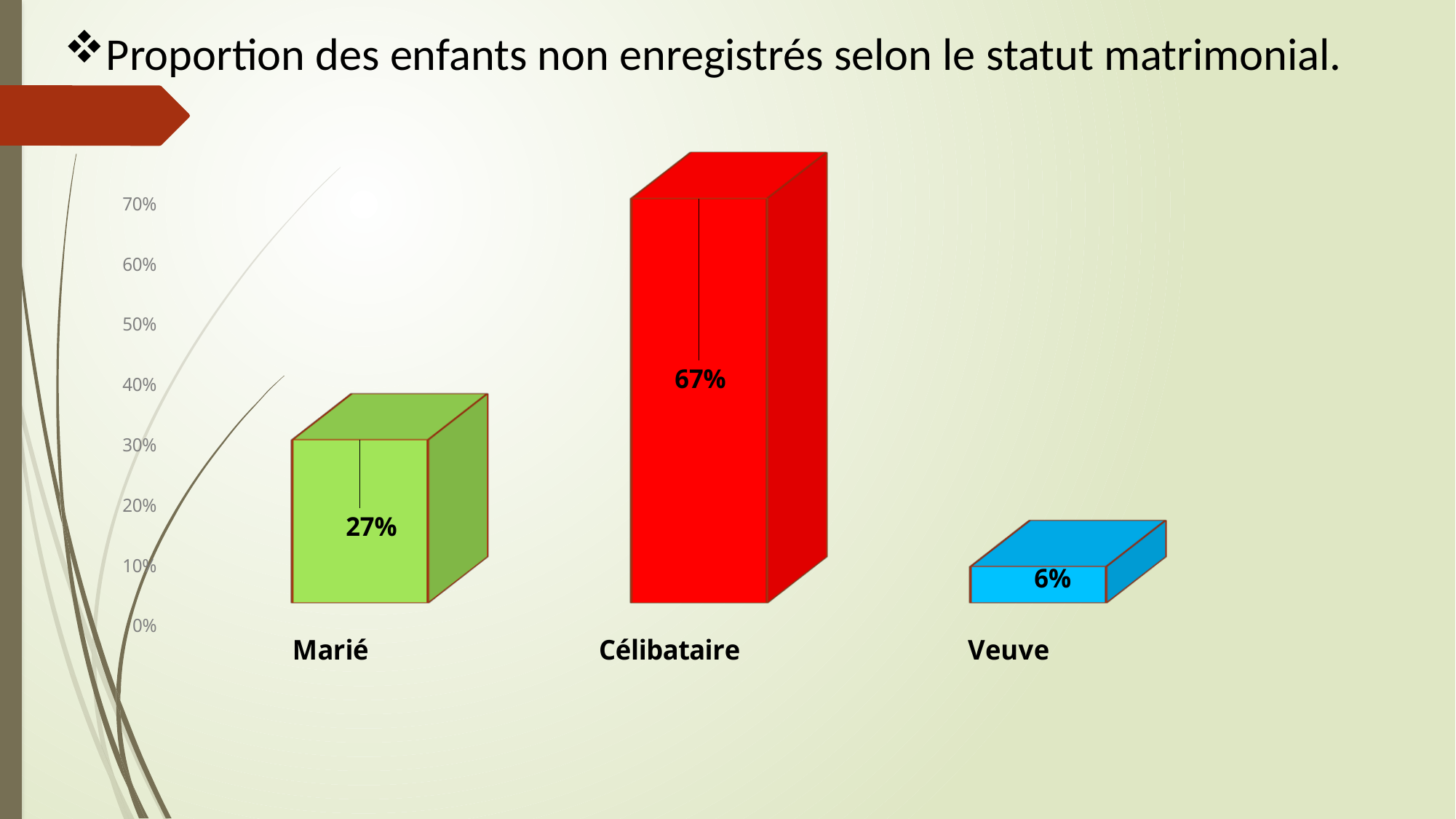
What kind of chart is shown on the slide? bar chart What is the difference between the values for Célibataire and Marié? 40% What is the value for Marié? 27% How many categories are shown in the chart? 3 Is the value for Célibataire greater or less than 60%? greater What is the value for Célibataire? 67% Which category has the lowest value? Veuve Which category has the highest value? Célibataire What is the value for Veuve? 6% Which is larger, the value for Marié or the value for Veuve? Marié What colour is the bar for Célibataire? red What is the difference between the values for Marié and Veuve? 21%